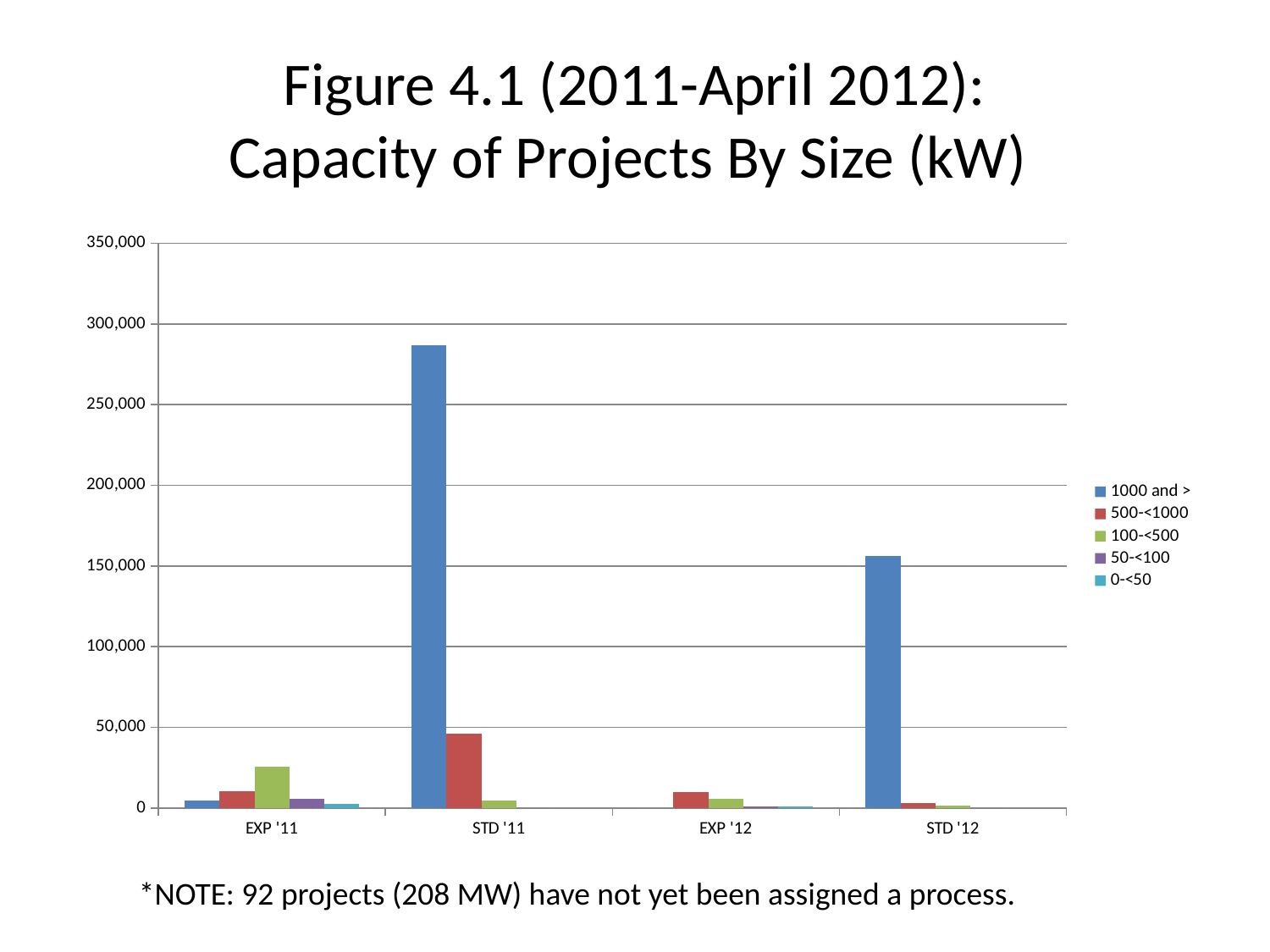
How many series does the legend list? 5 How many categories are shown along the x axis? 4 What is the title of the chart? Figure 4.1 (2011-April 2012): Capacity of Projects By Size (kW) Is the value for the 100-<500 series in EXP '11 greater or less than 50,000? less Is the value for the 1000 and > series in STD '11 greater or less than 250,000? greater For the 1000 and > series, which is larger: STD '11 or STD '12? STD '11 Is the value for the 1000 and > series in STD '12 greater or less than 200,000? less In the EXP '11 category, which is larger: the 100-<500 series or the 500-<1000 series? 100-<500 What kind of chart is shown on the slide? bar chart Which category has the tallest bar in the chart? STD '11 Which series has the highest value in the STD '11 category? 1000 and >